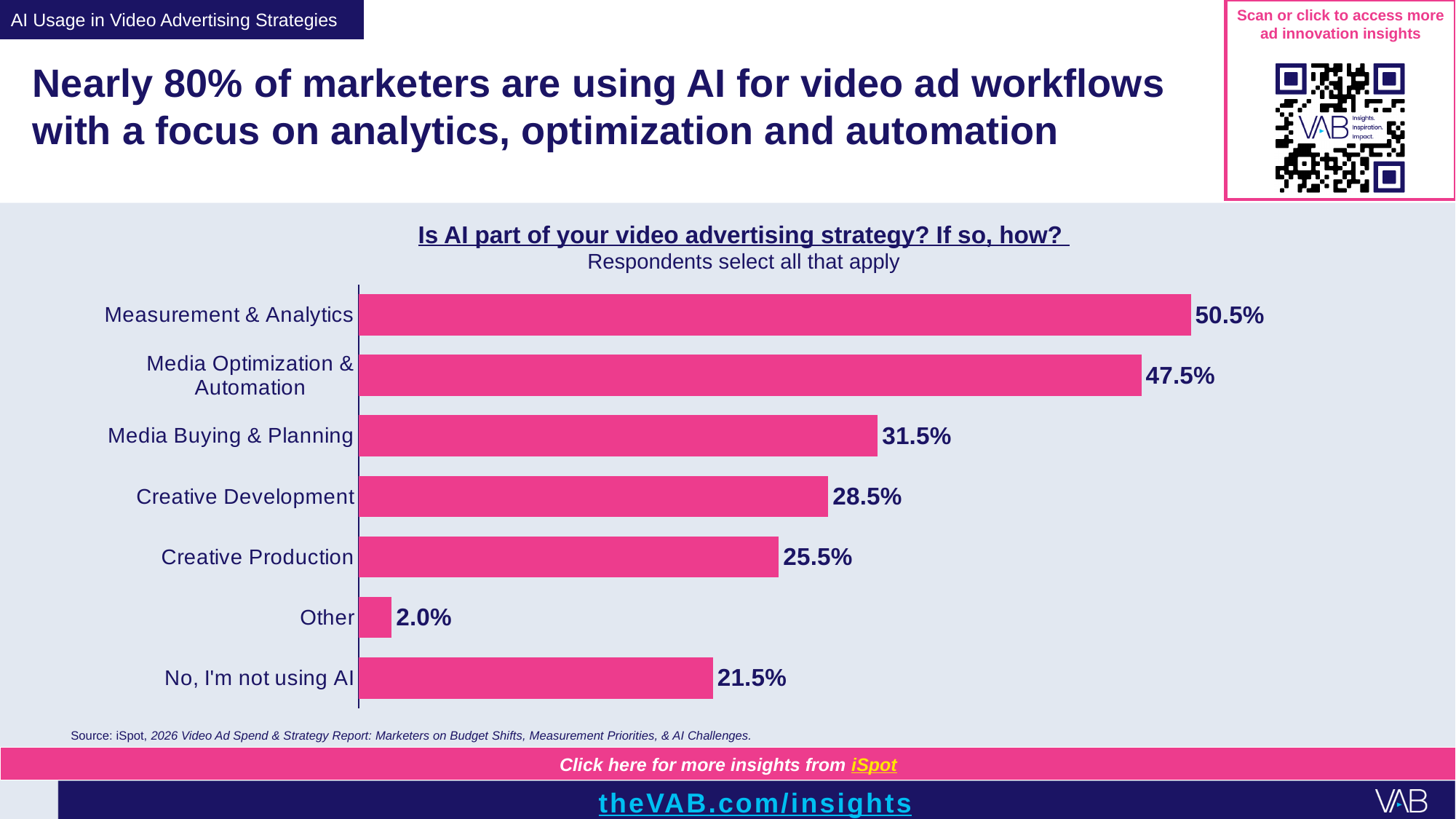
What is the difference between Measurement & Analytics and Media Optimization & Automation? 3.0% Which category has the lowest percentage? Other What type of chart is shown on the slide? Bar chart Which category has the highest percentage? Measurement & Analytics What percentage of respondents selected Measurement & Analytics? 50.5% What percentage of respondents said they are not using AI? 21.5% Which is larger, Creative Development or Creative Production? Creative Development What percentage of respondents selected Creative Production? 25.5% How many categories are shown in the chart? 7 What is the title of the chart? Is AI part of your video advertising strategy? If so, how? What percentage of respondents selected Media Optimization & Automation? 47.5% What is the difference between Media Buying & Planning and Creative Development? 3.0%